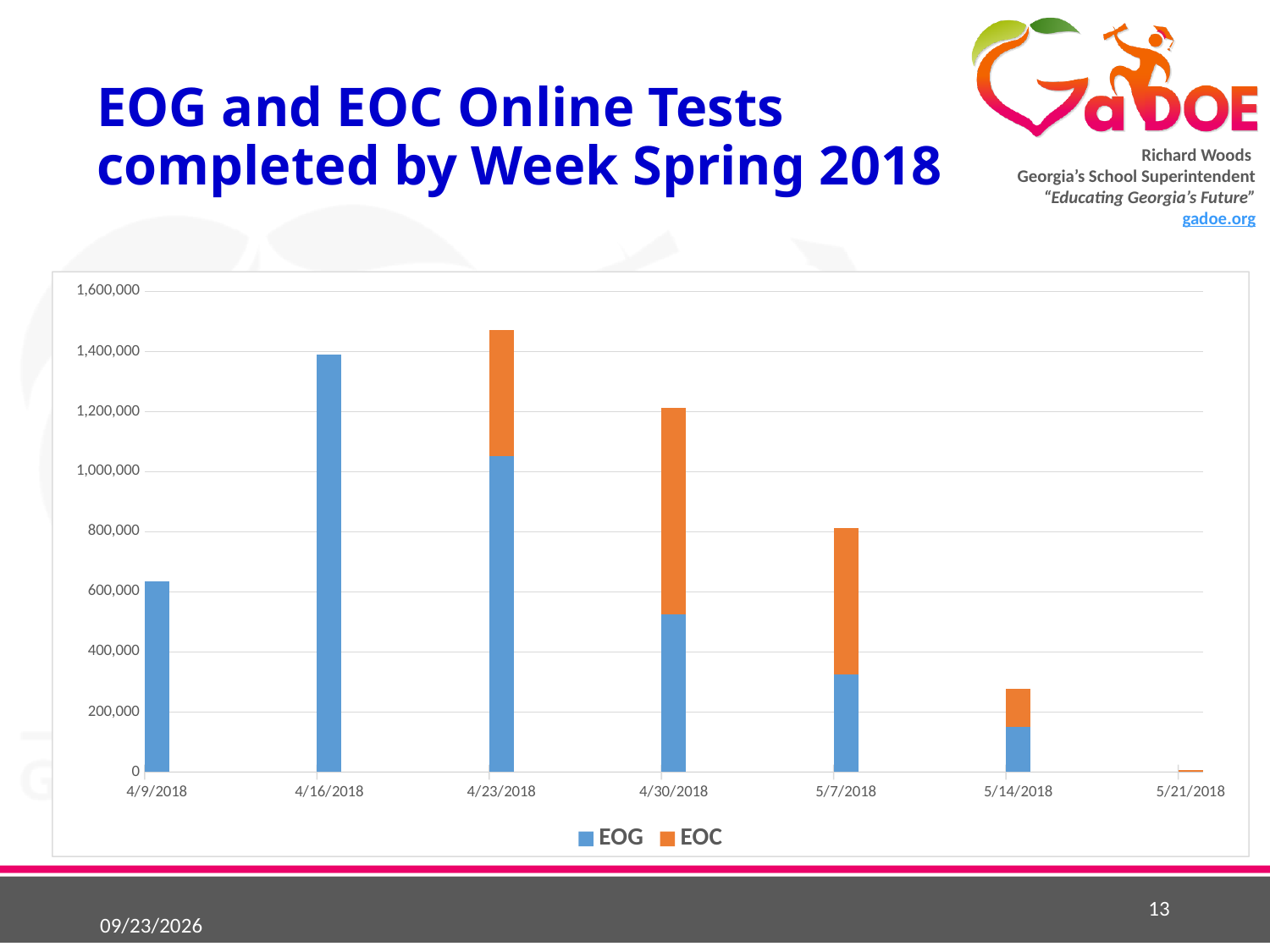
Is the EOG value for 4/9/2018 greater or less than 600,000? greater How many series does the legend list? 2 Is the EOG value for 4/30/2018 greater or less than 600,000? less How many weeks (categories) are shown on the x axis? 7 Which is larger, the EOC value for 4/30/2018 or the EOC value for 5/7/2018? 4/30/2018 What colour represents the EOC series in the chart? orange Is the EOG value for 4/16/2018 greater or less than 1,200,000? greater Which week has the highest EOG value? 4/16/2018 Which week has the highest EOC value? 4/30/2018 What kind of chart is shown on the slide? bar chart Which week has the tallest stacked bar overall? 4/23/2018 From 4/16/2018 to 5/21/2018, do the EOG values rise or fall along the x axis? fall